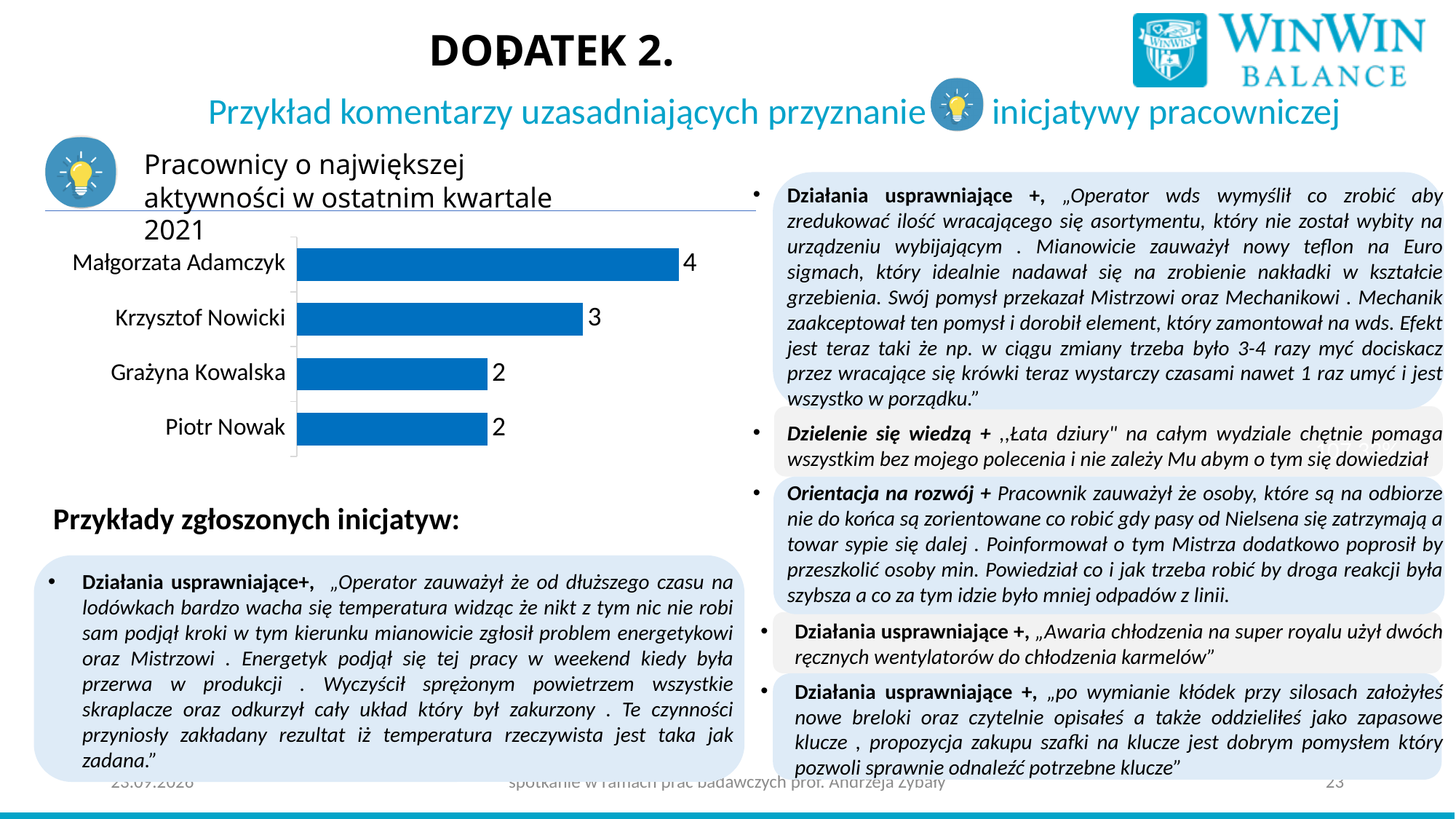
What kind of chart is shown on the slide? bar chart What value is shown for Piotr Nowak? 2 What colour are the bars in the chart? blue What value is shown for Małgorzata Adamczyk? 4 What is the title of the chart? Pracownicy o największej aktywności w ostatnim kwartale 2021 What value is shown for Krzysztof Nowicki? 3 What is the difference between the values for Małgorzata Adamczyk and Piotr Nowak? 2 What is the difference between the values for Małgorzata Adamczyk and Krzysztof Nowicki? 1 Which employee has the highest value in the chart? Małgorzata Adamczyk What value is shown for Grażyna Kowalska? 2 How many employees are shown in the chart? 4 Which is larger, the value for Krzysztof Nowicki or the value for Grażyna Kowalska? Krzysztof Nowicki